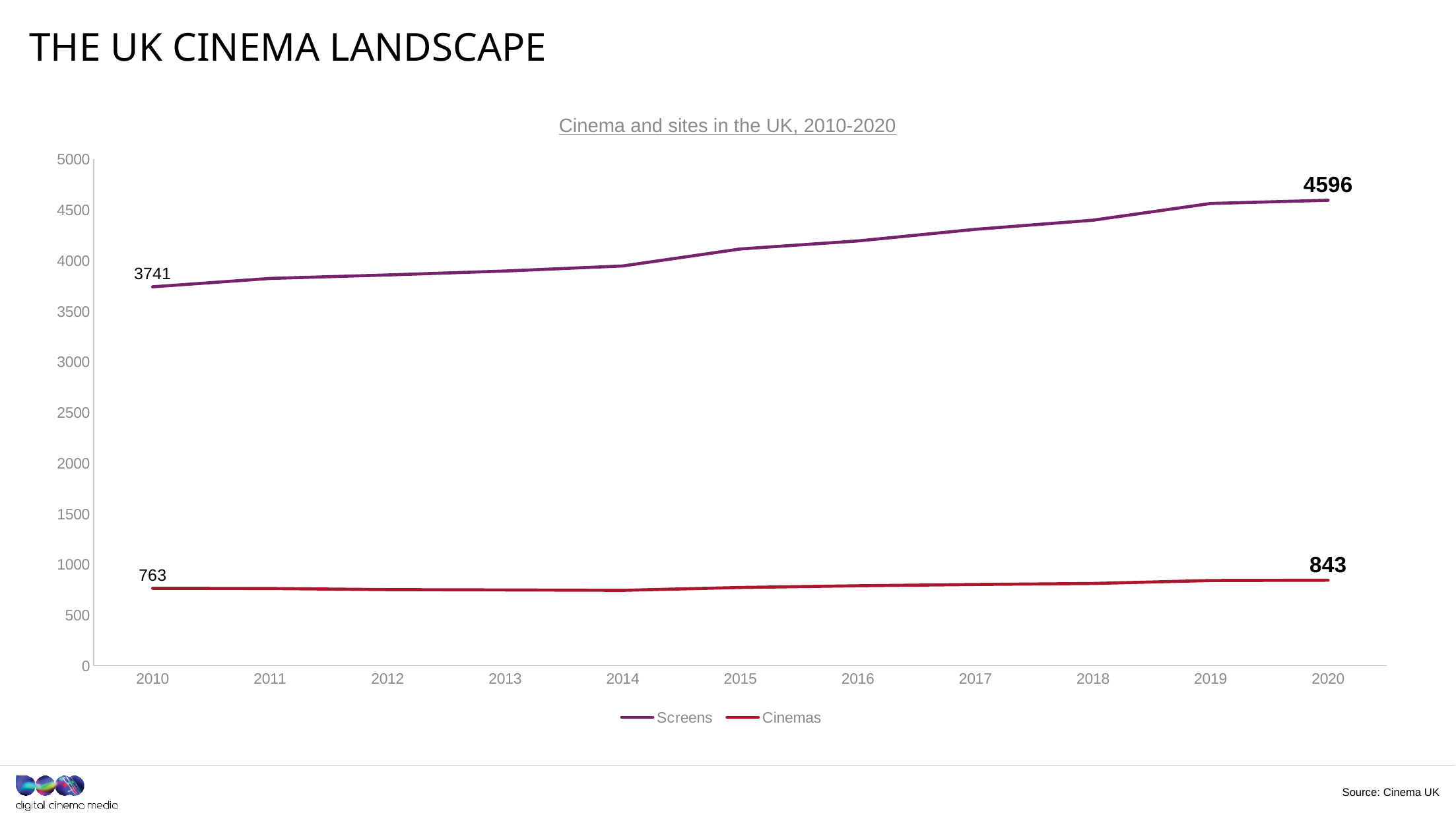
Is the value for Cinemas in 2014 greater or less than 1000? less Is the value for Screens in 2015 greater or less than 4000? greater By how much did the number of Cinemas increase from 2010 to 2020? 80 What is the value for Cinemas in 2010? 763 Which series has the higher value in 2020, Screens or Cinemas? Screens What is the value for Cinemas in 2020? 843 What is the value for Screens in 2020? 4596 By how much did the number of Screens increase from 2010 to 2020? 855 How many series does the legend list? 2 What is the value for Screens in 2010? 3741 How many years are shown on the x axis? 11 What kind of chart is shown on the slide? Line chart